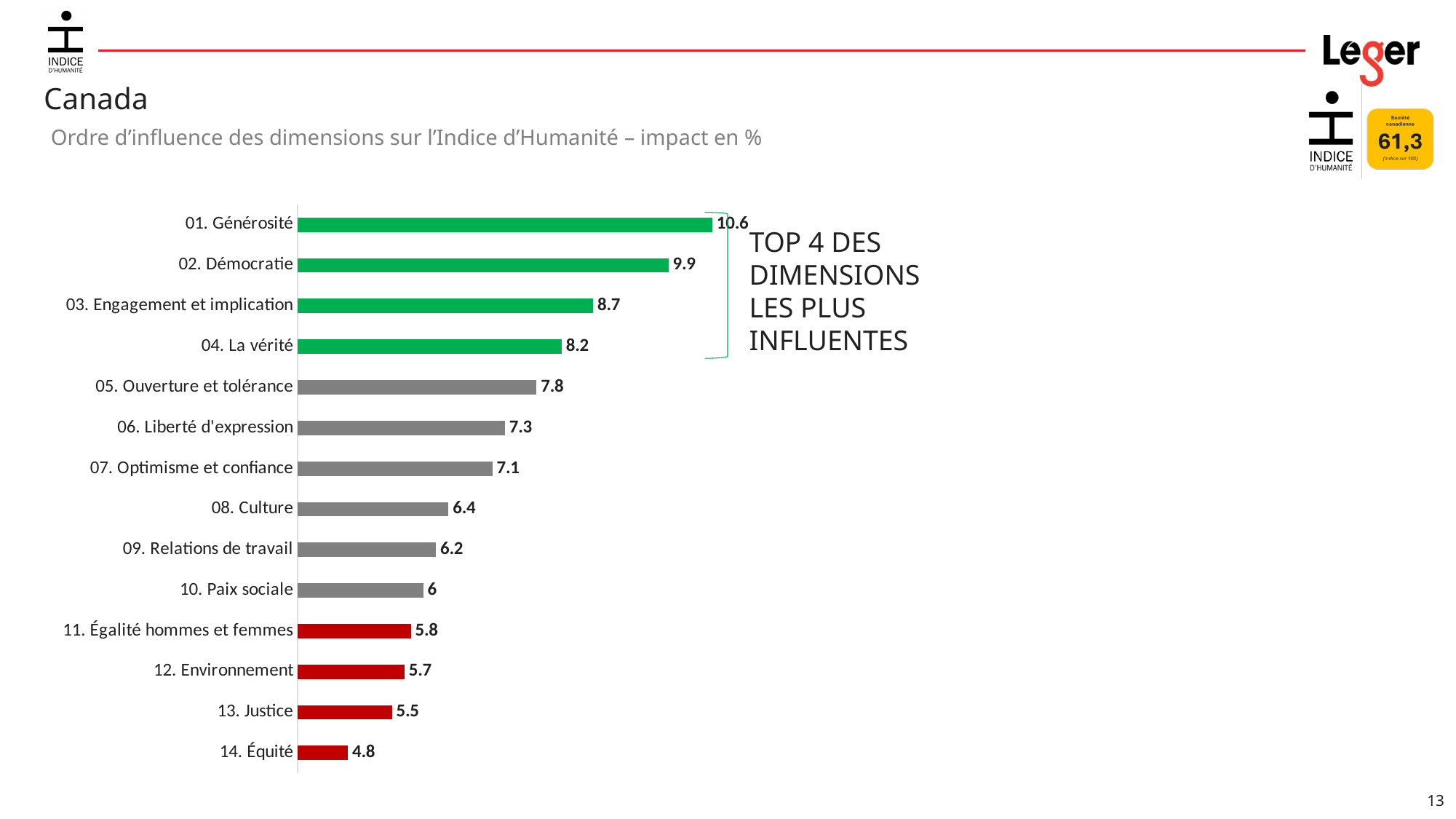
What kind of chart is shown on the slide? Bar chart What is the difference between the values for 04. La vérité and 14. Équité? 3.4 What is the value for 01. Générosité? 10.6 What is the value for 13. Justice? 5.5 What is the value for 08. Culture? 6.4 Which dimension has the lowest value? 14. Équité How many bars are coloured green in the chart? 4 How many dimensions are shown in the chart? 14 What is the difference between the values for 01. Générosité and 02. Démocratie? 0.7 Which dimension has the highest value? 01. Générosité What is the value for 12. Environnement? 5.7 Which has a larger value, 05. Ouverture et tolérance or 10. Paix sociale? 05. Ouverture et tolérance